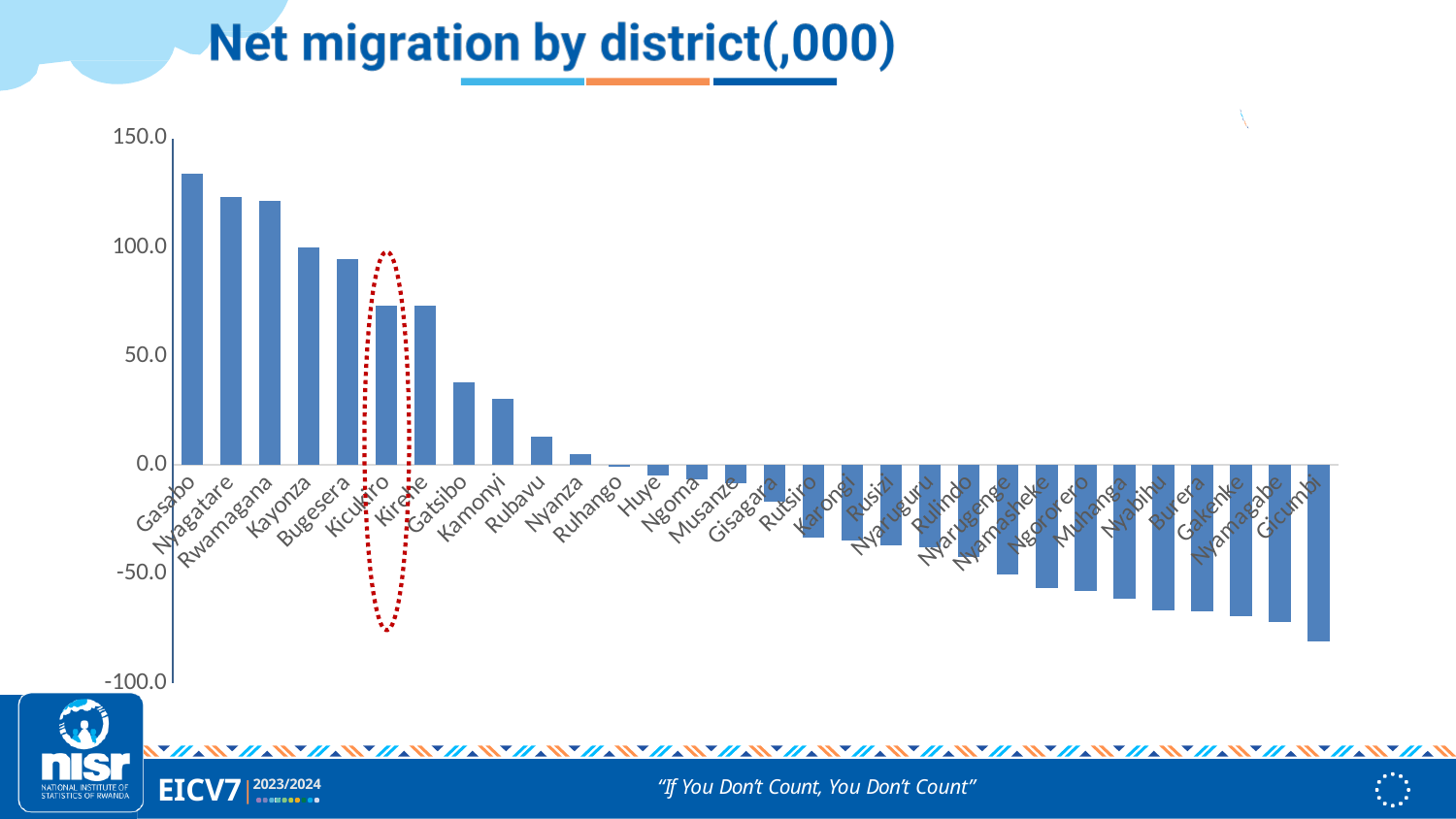
What kind of chart is shown on the slide? bar chart Which district has the lowest net migration? Gicumbi Do the values rise or fall moving from left to right along the x axis? fall How many districts are shown on the x axis? 30 Is the value for Gicumbi greater or less than -50.0? less Which district has the highest net migration? Gasabo Is the value for Kicukiro greater or less than 50.0? greater Is the value for Gasabo greater or less than 100.0? greater Which has the larger net migration, Gatsibo or Kamonyi? Gatsibo Which district's bar is highlighted with a red dotted circle? Kicukiro